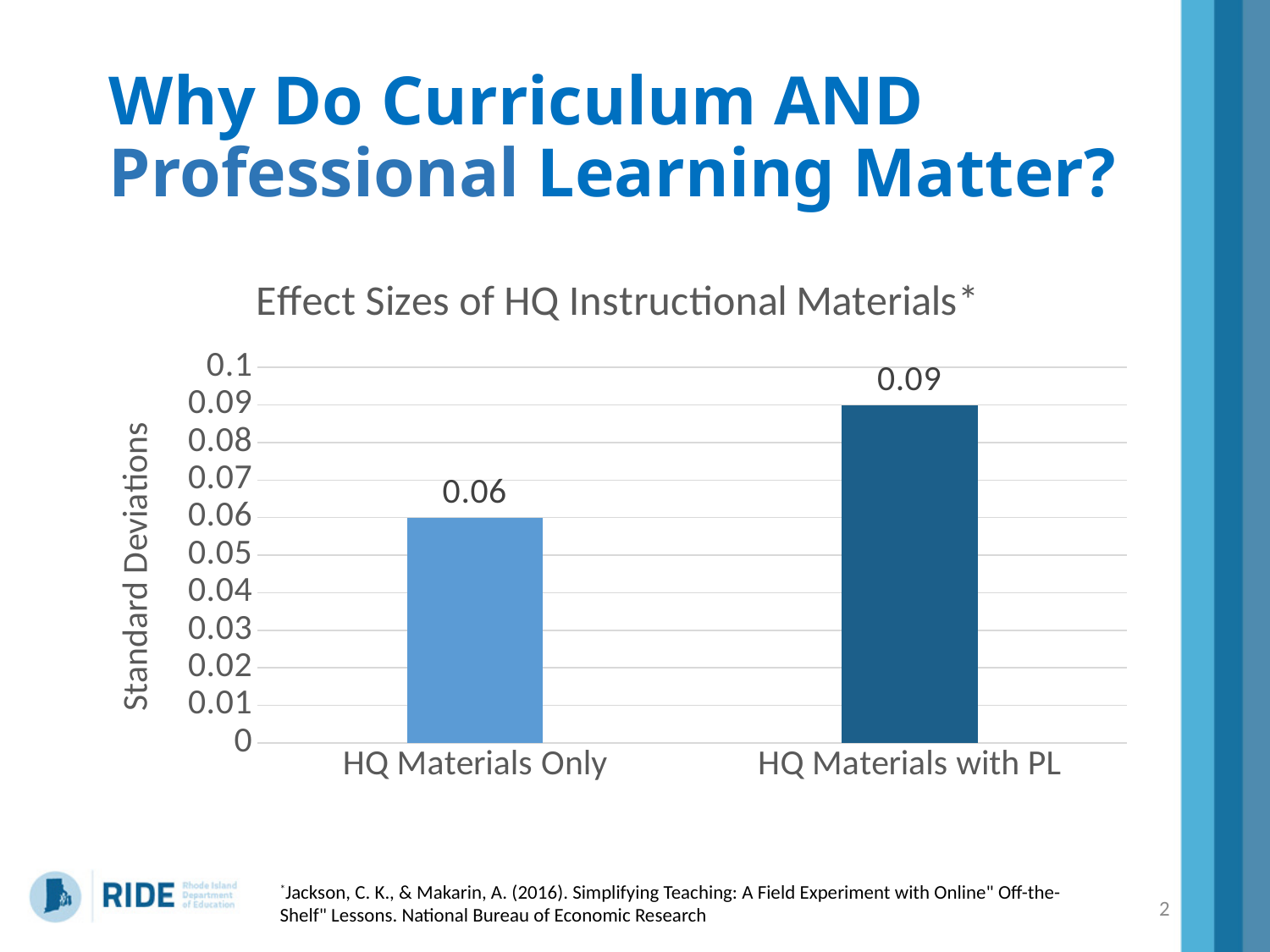
What is the label of the vertical axis? Standard Deviations What is the effect size for HQ Materials Only? 0.06 Which category has the lowest effect size? HQ Materials Only What is the difference between the effect sizes for HQ Materials with PL and HQ Materials Only? 0.03 What is the title of the chart? Effect Sizes of HQ Instructional Materials* Which category has the highest effect size? HQ Materials with PL What is the effect size for HQ Materials with PL? 0.09 What kind of chart is shown on the slide? Bar chart Is the value for HQ Materials Only greater or less than 0.07? less Is the value for HQ Materials with PL greater or less than 0.08? greater How many categories are shown in the chart? 2 Which is larger, the effect size for HQ Materials Only or for HQ Materials with PL? HQ Materials with PL